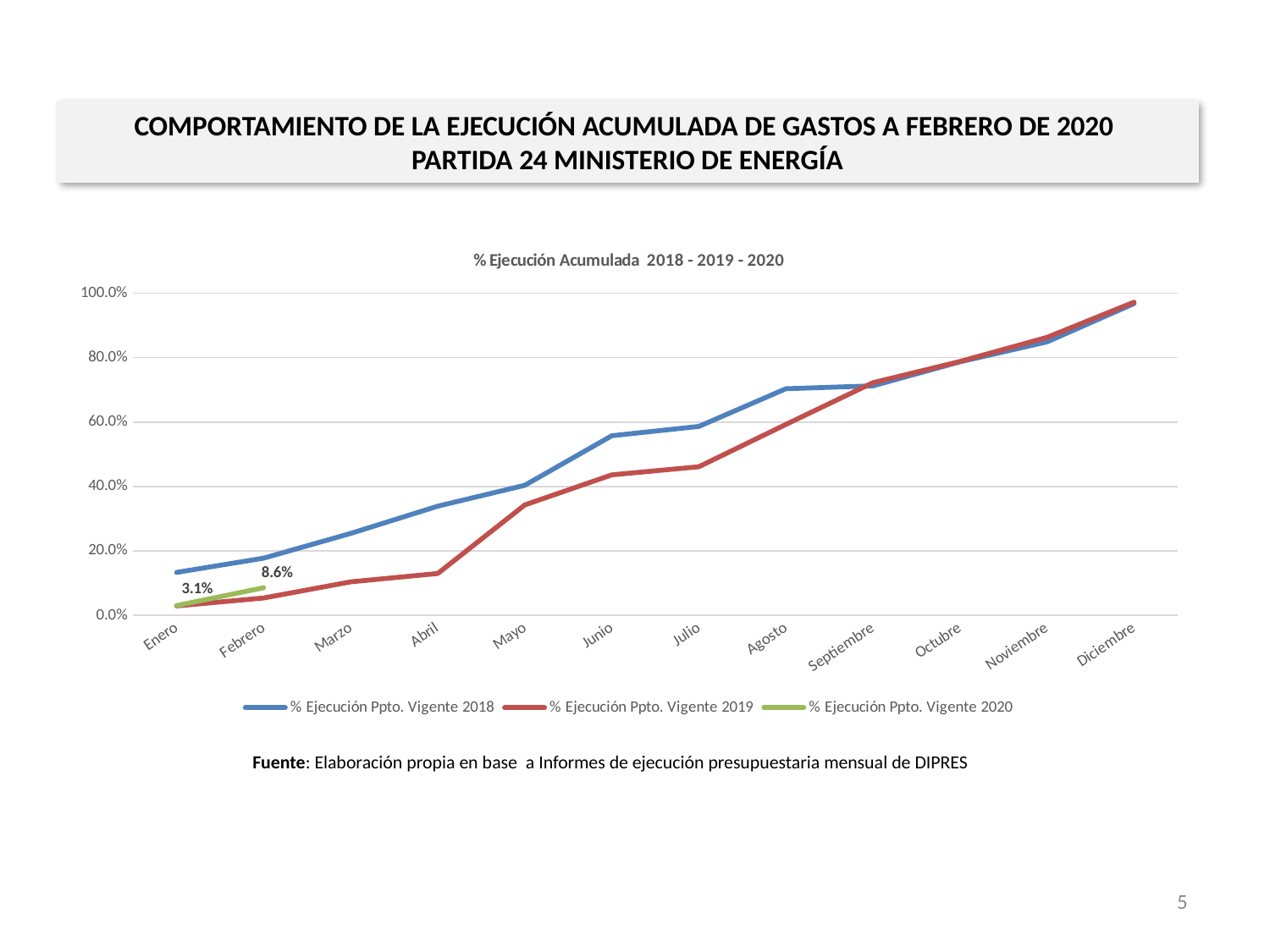
What is the title of the chart? % Ejecución Acumulada 2018 - 2019 - 2020 How many series does the legend list? 3 By how much did % Ejecución Ppto. Vigente 2020 increase from Enero to Febrero? 5.5% Is the value for % Ejecución Ppto. Vigente 2018 in Agosto greater or less than 60%? greater What kind of chart is shown on the slide? line chart How many months are shown along the x axis? 12 Is the value for % Ejecución Ppto. Vigente 2018 in Junio greater or less than 40%? greater What is the value of % Ejecución Ppto. Vigente 2020 for Enero? 3.1% Do the values for % Ejecución Ppto. Vigente 2018 rise or fall from Enero to Diciembre? rise In Junio, which series has the larger value, % Ejecución Ppto. Vigente 2018 or % Ejecución Ppto. Vigente 2019? % Ejecución Ppto. Vigente 2018 Is the value for % Ejecución Ppto. Vigente 2019 in Abril greater or less than 20%? less What is the value of % Ejecución Ppto. Vigente 2020 for Febrero? 8.6%